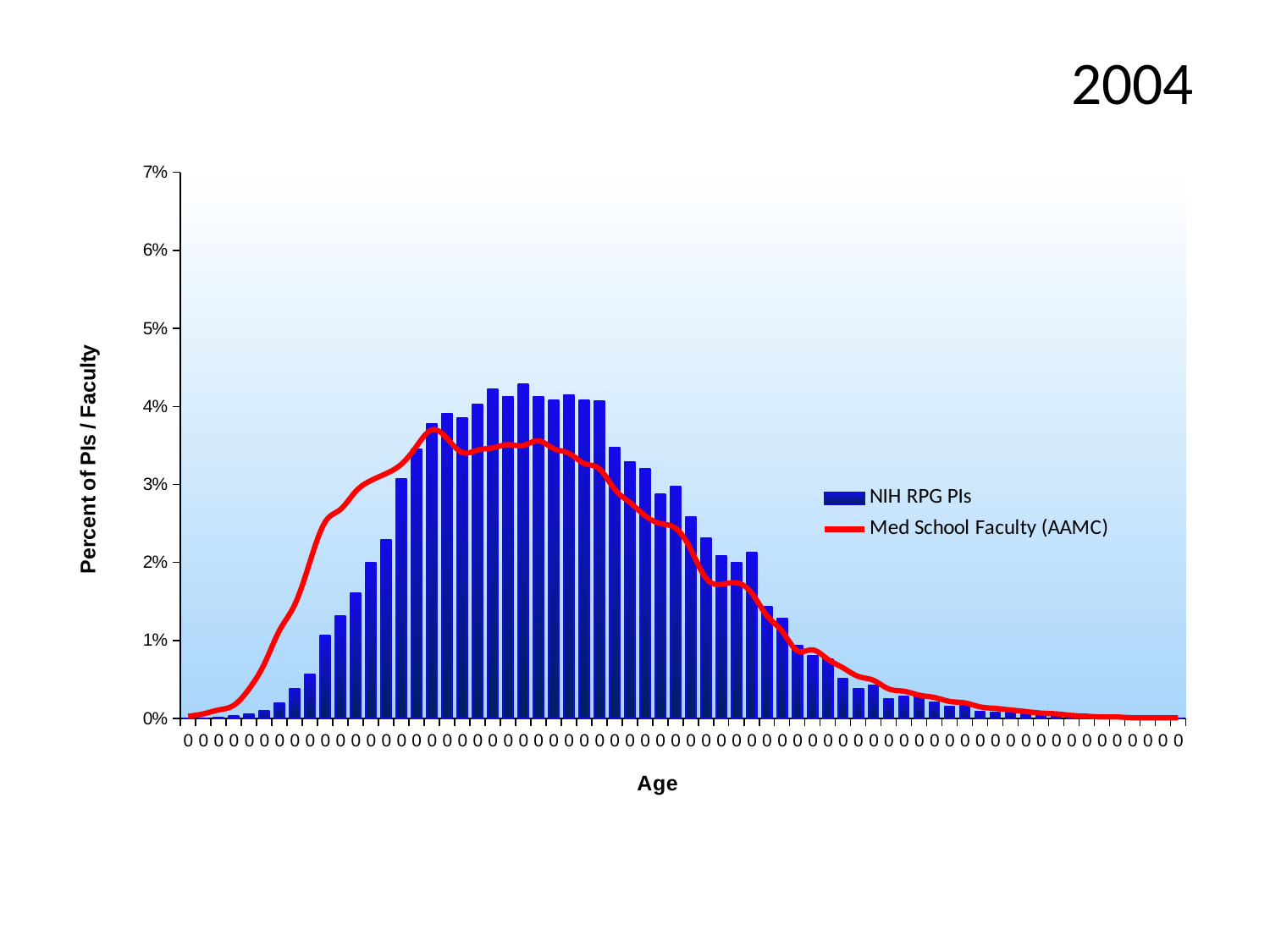
Which series reaches the higher peak value, NIH RPG PIs or Med School Faculty (AAMC)? NIH RPG PIs Is the peak of the Med School Faculty (AAMC) line greater or less than 4%? less How many series does the legend list? 2 Toward the right end of the x axis, do the NIH RPG PIs bars rise or fall? fall What kind of chart is shown on the slide? A bar chart with a line overlay Is the tallest NIH RPG PIs bar greater or less than 5%? less Is the tallest NIH RPG PIs bar greater or less than 4%? greater Which series is drawn as the red line? Med School Faculty (AAMC) What year is shown as the slide title? 2004